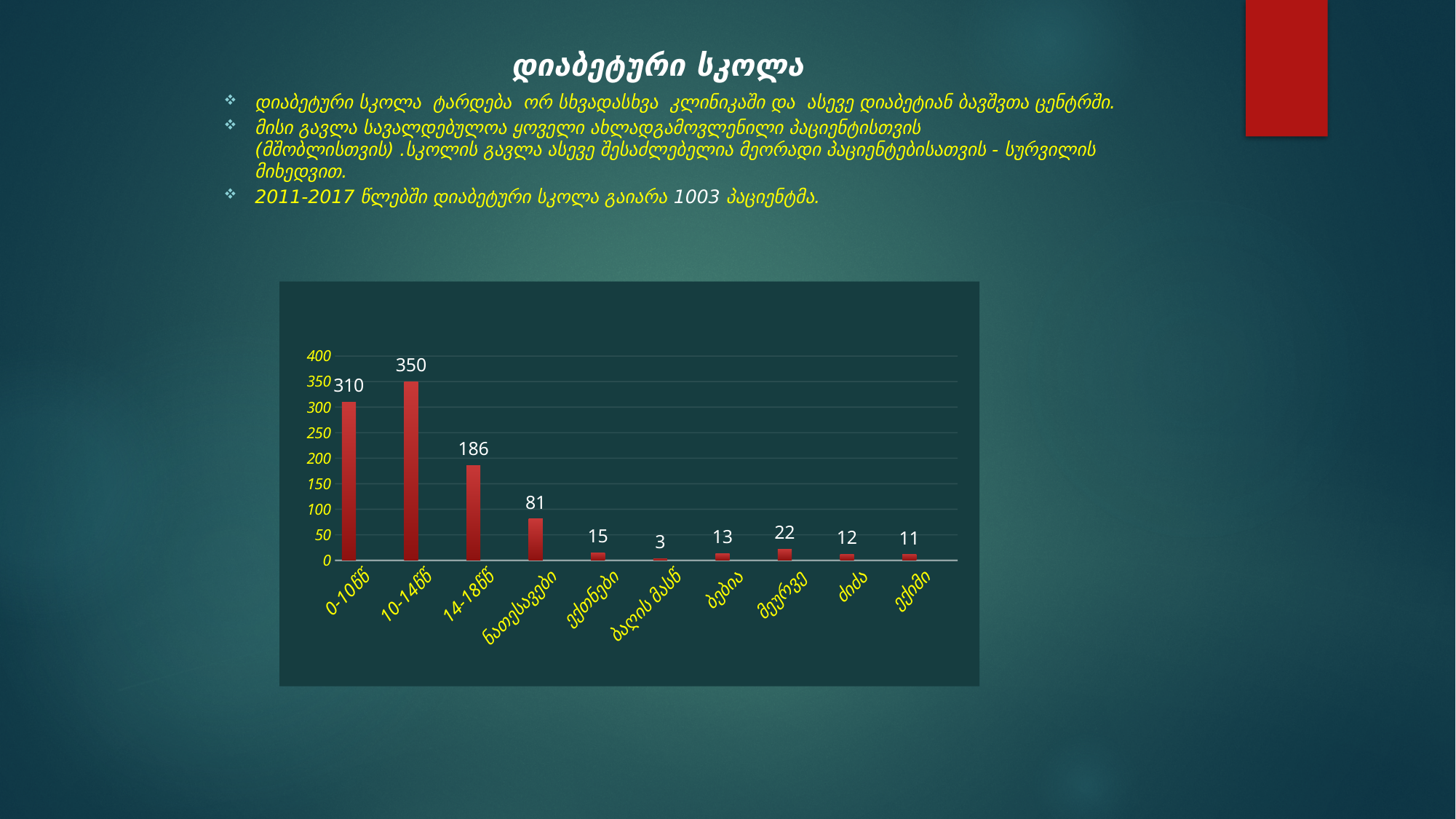
Which category has the lowest value? ბაღის მასწ What is the value for the category ექიმი? 11 Which is larger, the value for ბებია or the value for ძიძა? ბებია What kind of chart is shown on the slide? bar chart Which category has the highest value? 10-14წწ Is the value for 14-18წწ greater or less than 150? greater What is the difference between the values for 0-10წწ and 14-18წწ? 124 What is the value for the category მეურვე? 22 What is the value for the category ნათესავები? 81 What is the value for the category 10-14წწ? 350 What colour are the bars in the chart? red How many categories are shown on the x axis? 10